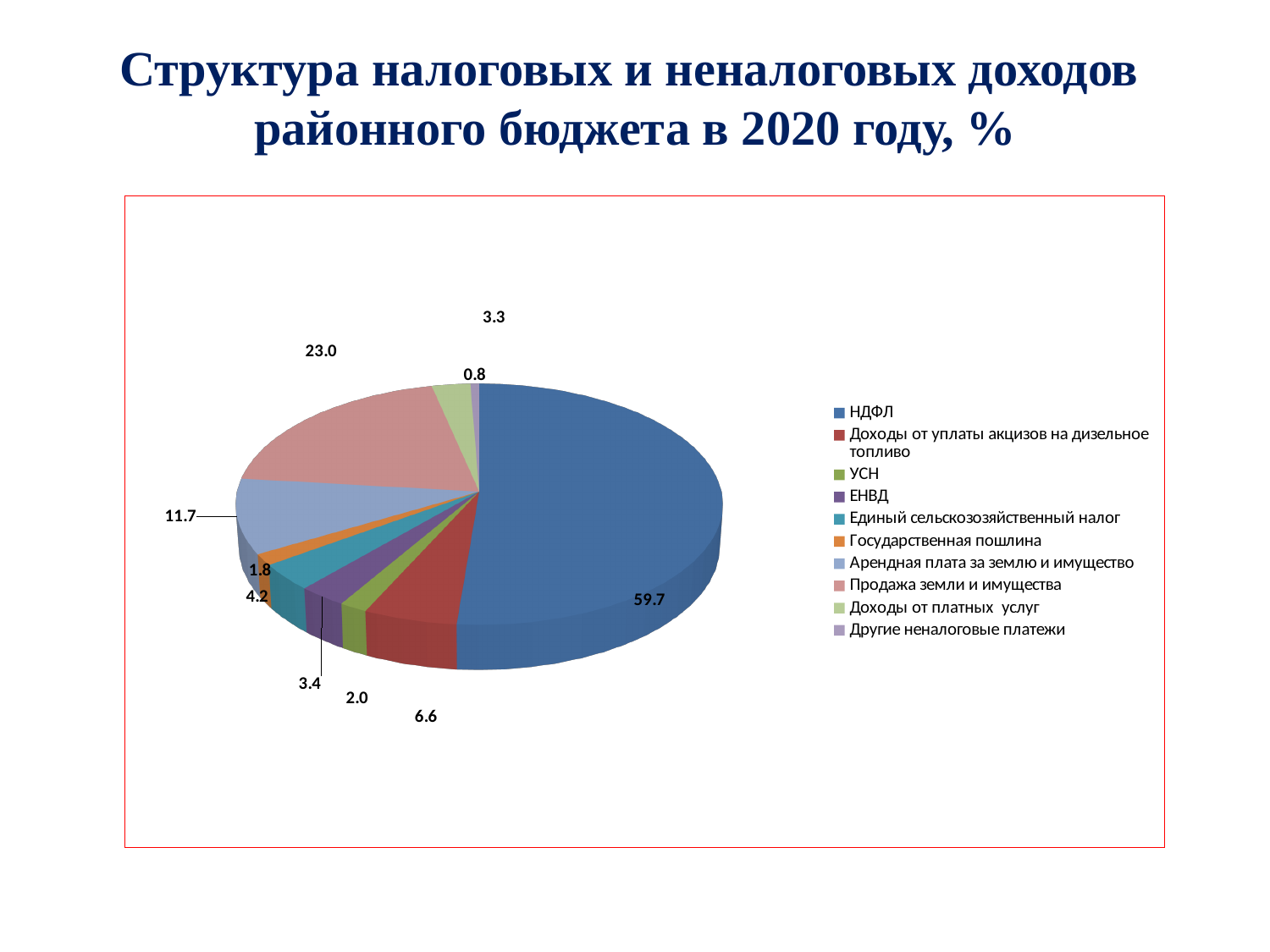
What is the difference between the values for НДФЛ and Продажа земли и имущества? 36.7 What is the value shown for Доходы от уплаты акцизов на дизельное топливо? 6.6 Which category has the largest slice of the pie? НДФЛ What is the title of the slide? Структура налоговых и неналоговых доходов районного бюджета в 2020 году, % What is the value shown for НДФЛ? 59.7 What is the value shown for Арендная плата за землю и имущество? 11.7 How many categories does the legend list? 10 What kind of chart is shown on the slide? pie chart Which is larger, the value for ЕНВД or the value for Единый сельскохозяйственный налог? Единый сельскохозяйственный налог What is the value shown for Государственная пошлина? 1.8 What is the value shown for Продажа земли и имущества? 23.0 Which category has the smallest slice of the pie? Другие неналоговые платежи